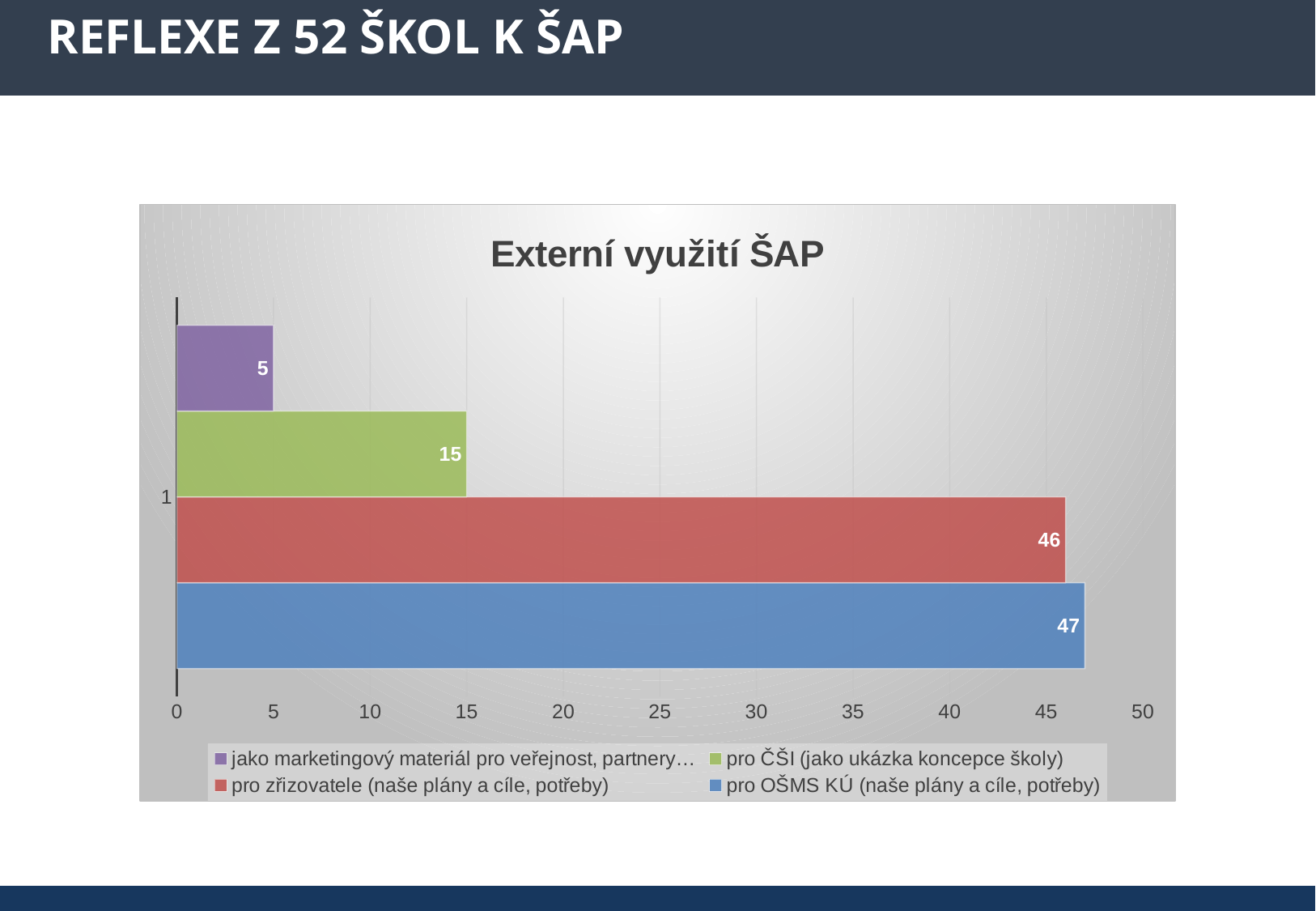
Which series has the highest value? pro OŠMS KÚ (naše plány a cíle, potřeby) What is the value for 'pro ČŠI (jako ukázka koncepce školy)'? 15 What is the title of the chart? Externí využití ŠAP What is the value for 'jako marketingový materiál pro veřejnost, partnery…'? 5 What is the value for 'pro OŠMS KÚ (naše plány a cíle, potřeby)'? 47 How many series does the legend list? 4 What is the value for 'pro zřizovatele (naše plány a cíle, potřeby)'? 46 Which is larger: the value for 'pro ČŠI (jako ukázka koncepce školy)' or for 'jako marketingový materiál pro veřejnost, partnery…'? pro ČŠI (jako ukázka koncepce školy) What kind of chart is shown? bar chart Which series has the lowest value? jako marketingový materiál pro veřejnost, partnery… What is the difference between the values for 'pro zřizovatele' and 'pro ČŠI'? 31 Is the value for 'pro zřizovatele (naše plány a cíle, potřeby)' greater or less than 40? greater